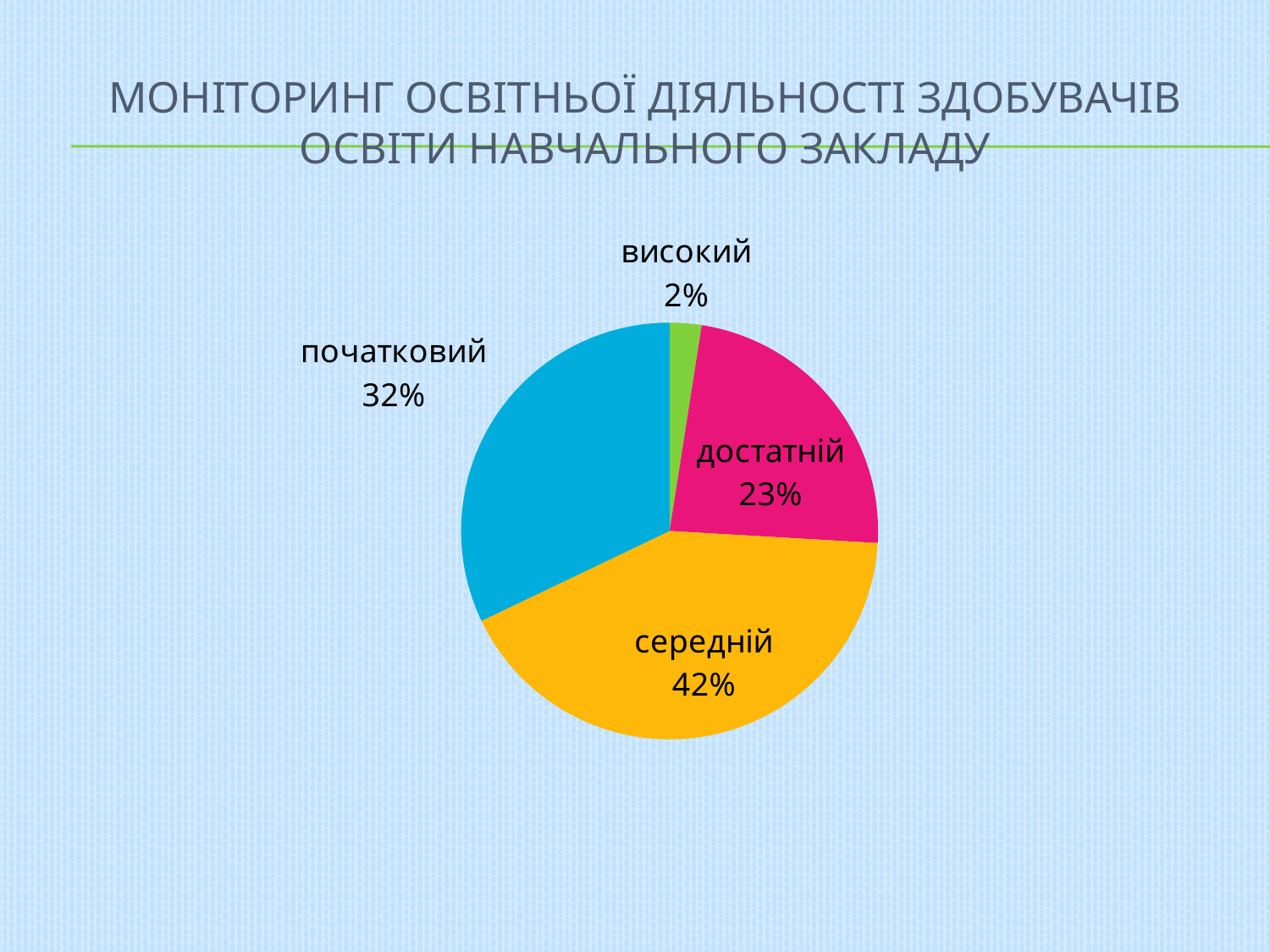
What kind of chart is shown on the slide? pie chart What percentage is shown for the "достатній" slice? 23% What is the difference in percentage points between the "достатній" and "високий" slices? 21 How many slices does the pie chart have? 4 Which category has the smallest slice of the pie? високий What is the difference in percentage points between the "середній" and "початковий" slices? 10 What percentage is shown for the "середній" slice? 42% Which category has the largest slice of the pie? середній Which is larger, the "достатній" slice or the "початковий" slice? початковий What colour is the "середній" slice? yellow What percentage is shown for the "високий" slice? 2% What percentage is shown for the "початковий" slice? 32%